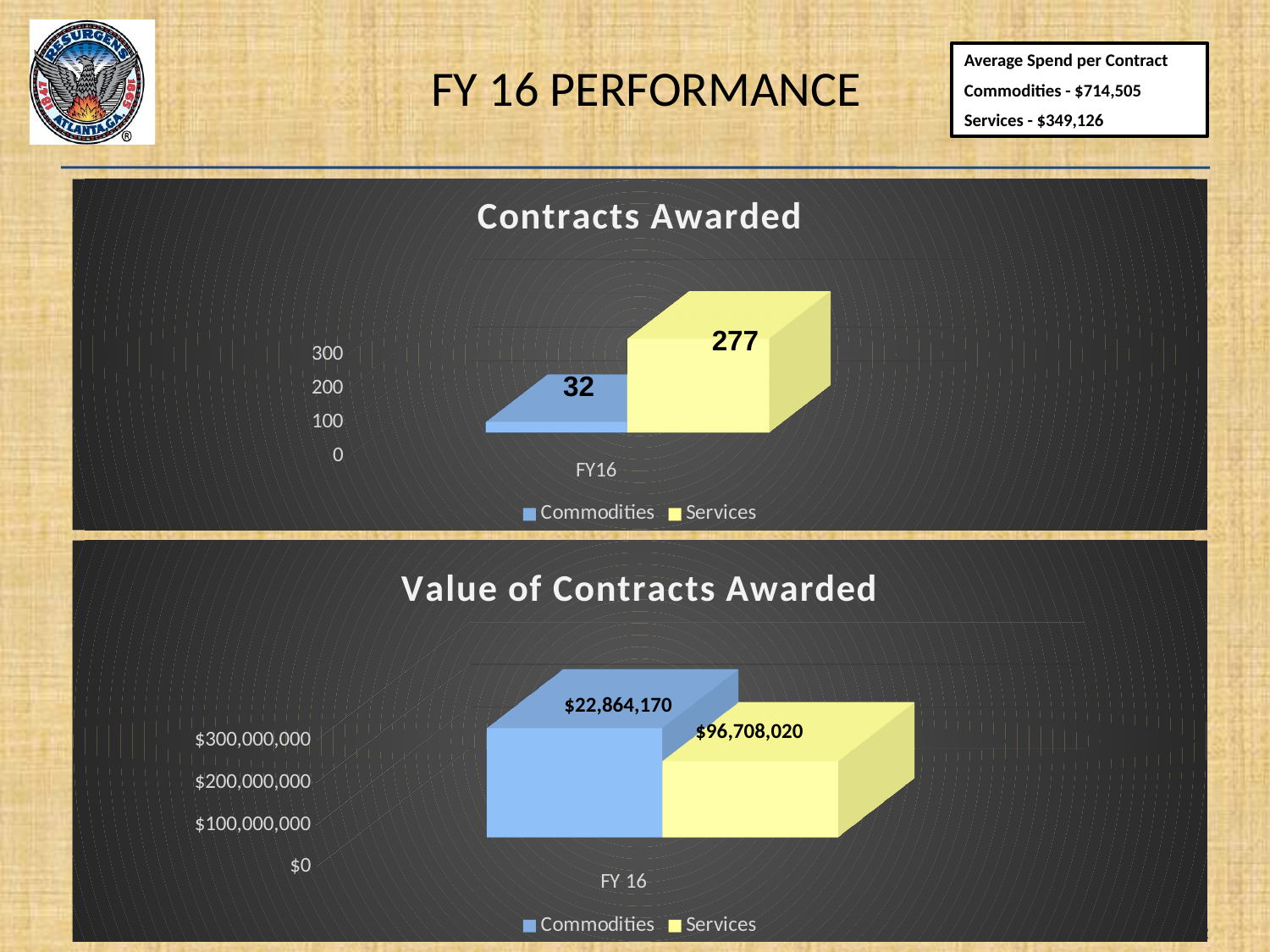
In the 'Value of Contracts Awarded' chart, what is the value for Commodities? $22,864,170 In the 'Contracts Awarded' chart, what is the difference between the Services and Commodities values? 245 In the 'Value of Contracts Awarded' chart, what category label appears on the x axis? FY 16 In the 'Value of Contracts Awarded' chart, what is the value for Services? $96,708,020 In the 'Contracts Awarded' chart, what colour represents the Services series? Yellow In the 'Contracts Awarded' chart, how many contracts were awarded for Services in FY16? 277 In the 'Value of Contracts Awarded' chart, what is the difference between the Services and Commodities values? $73,843,850 In the 'Contracts Awarded' chart, how many contracts were awarded for Commodities in FY16? 32 In the 'Contracts Awarded' chart, what kind of chart is shown? Bar chart In the 'Contracts Awarded' chart, which series has the higher value? Services In the 'Contracts Awarded' chart, how many series does the legend list? 2